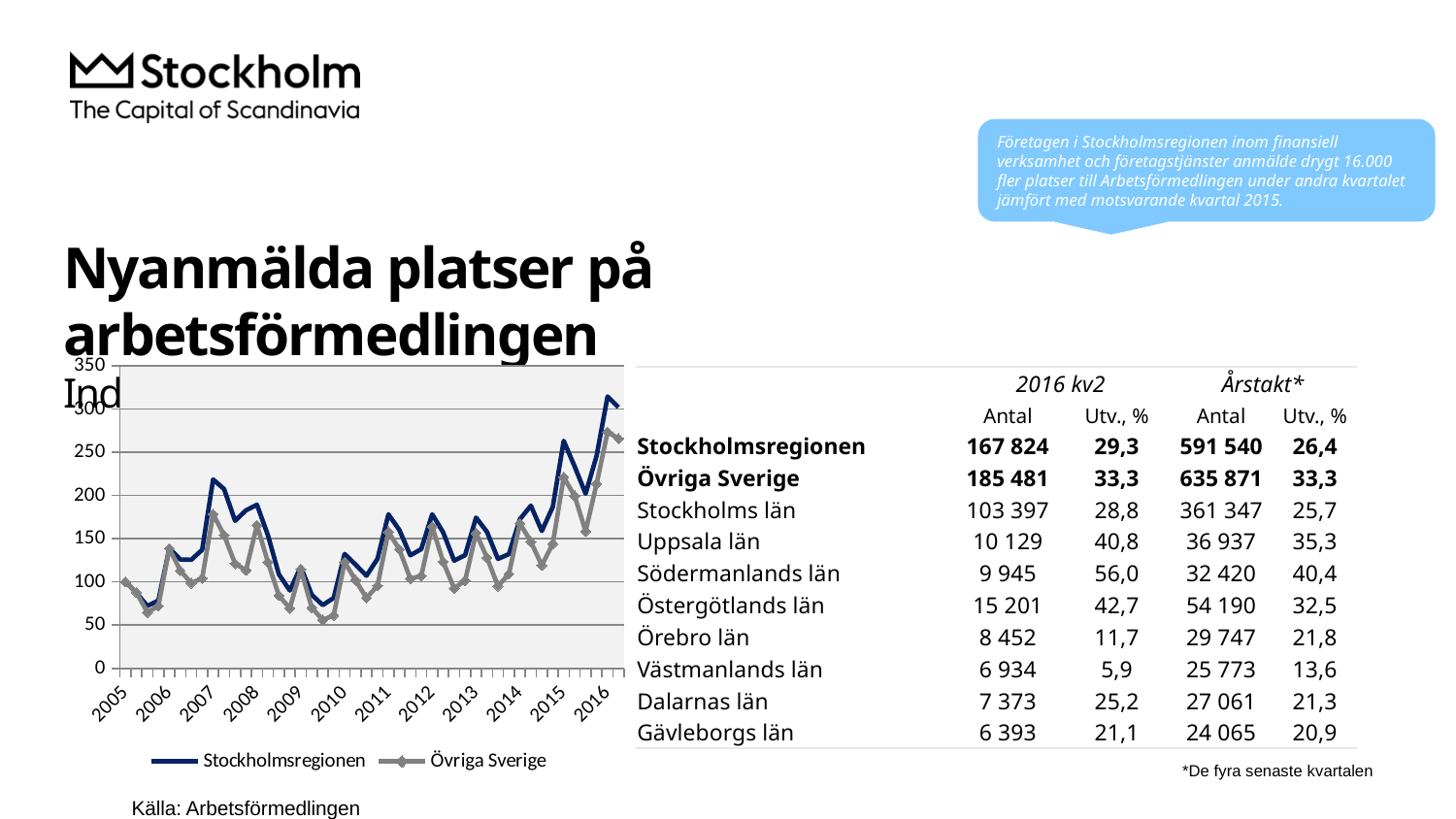
Which two series are listed in the chart legend? Stockholmsregionen and Övriga Sverige Overall, do the values for Stockholmsregionen rise or fall from 2005 to 2016? rise How many year labels are shown on the x axis of the chart? 12 Is the lowest value for Övriga Sverige, around 2009–2010, greater or less than 100? less Is the final 2016 value for Övriga Sverige greater or less than 300? less Is the 2007 peak value for Stockholmsregionen greater or less than 200? greater How many series does the chart legend list? 2 At the last point in 2016, which series has the higher value, Stockholmsregionen or Övriga Sverige? Stockholmsregionen Which series reaches the highest point on the chart? Stockholmsregionen What is the highest value shown on the chart's y axis? 350 What kind of chart is shown on the slide? Line chart